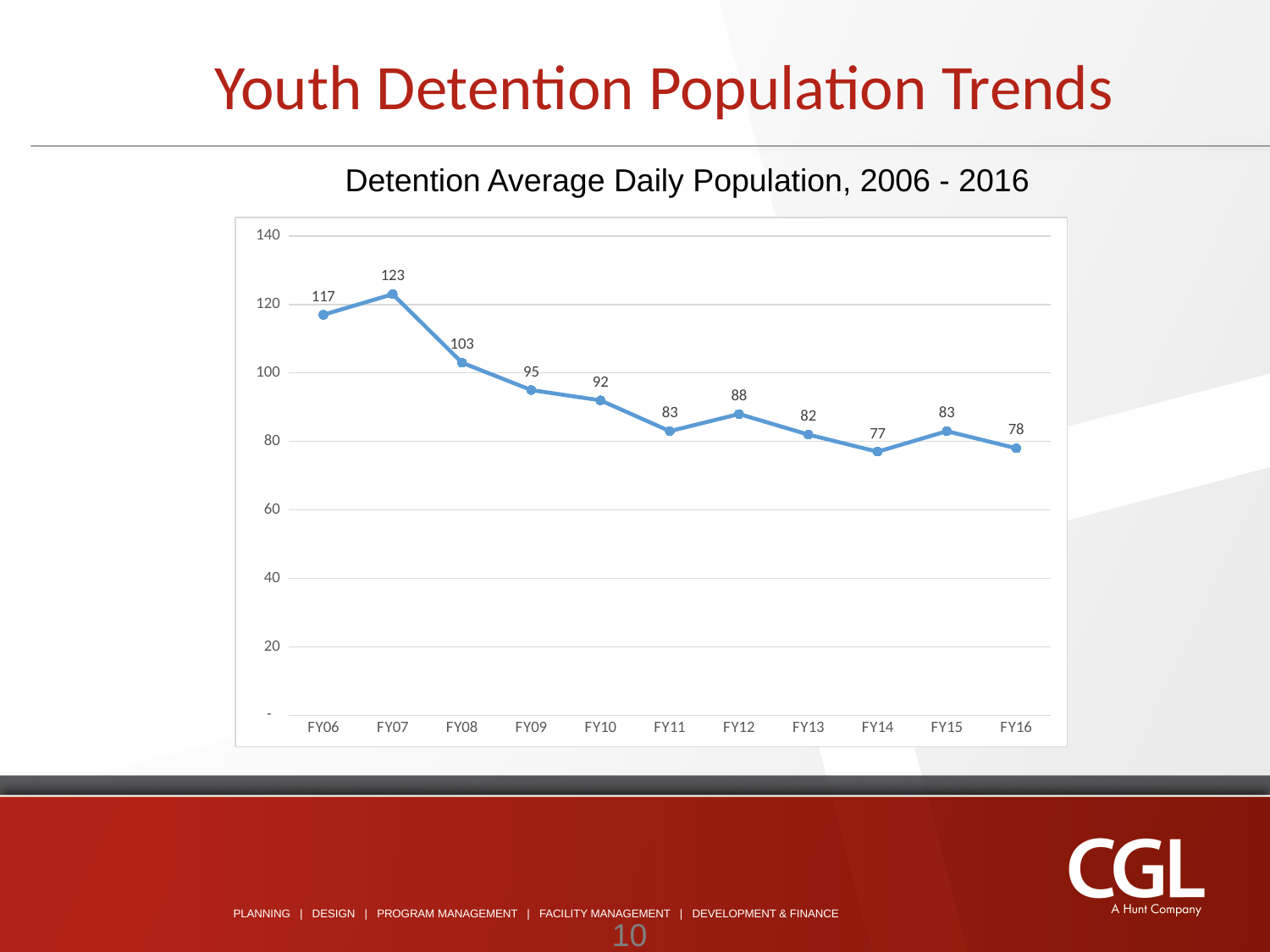
What is the value plotted for FY10? 92 Which fiscal year has the lowest average daily population? FY14 Which fiscal year has the highest average daily population? FY07 What is the difference between the FY07 value and the FY16 value? 45 Is the value for FY08 greater or less than 100? greater What is the difference between the FY08 value and the FY09 value? 8 What kind of chart is shown on the slide? line chart What is the detention average daily population for FY06? 117 Which is larger, the value for FY12 or the value for FY13? FY12 How many fiscal years are plotted on the x axis? 11 Overall, do the values rise or fall from FY06 to FY16? fall What is the detention average daily population for FY14? 77